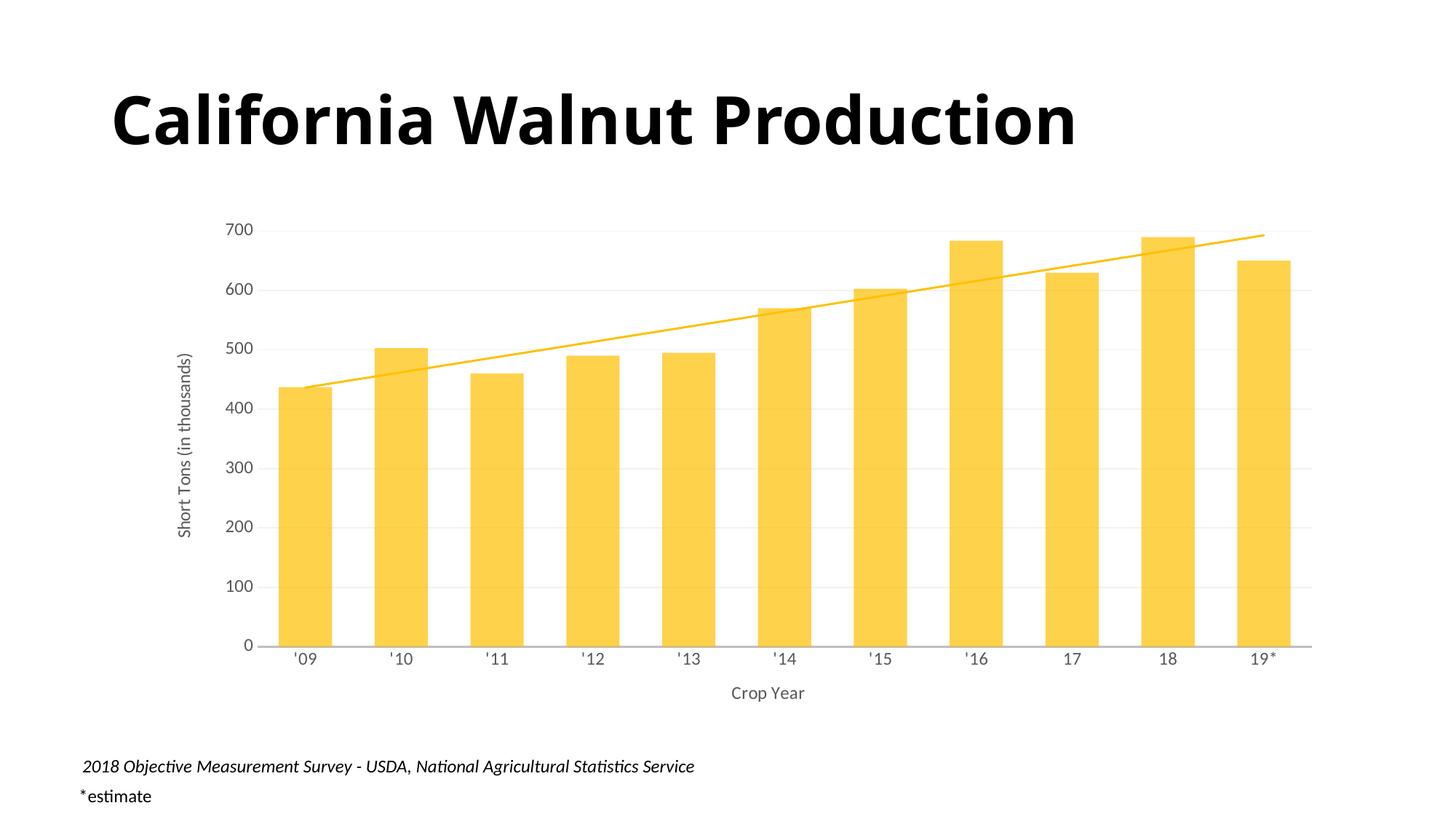
How many crop years are shown on the x axis? 11 Is the value for 19* greater or less than 600? greater What is the label of the vertical axis? Short Tons (in thousands) Overall, do the values rise or fall from '09 to 19*? rise Which is larger, the value for '16 or the value for 17? '16 Which is larger, the value for '13 or the value for '14? '14 Is the value for '11 greater or less than 500? less Is the value for '14 greater or less than 500? greater Which crop year has the lowest walnut production? '09 What kind of chart is shown on the slide? Bar chart